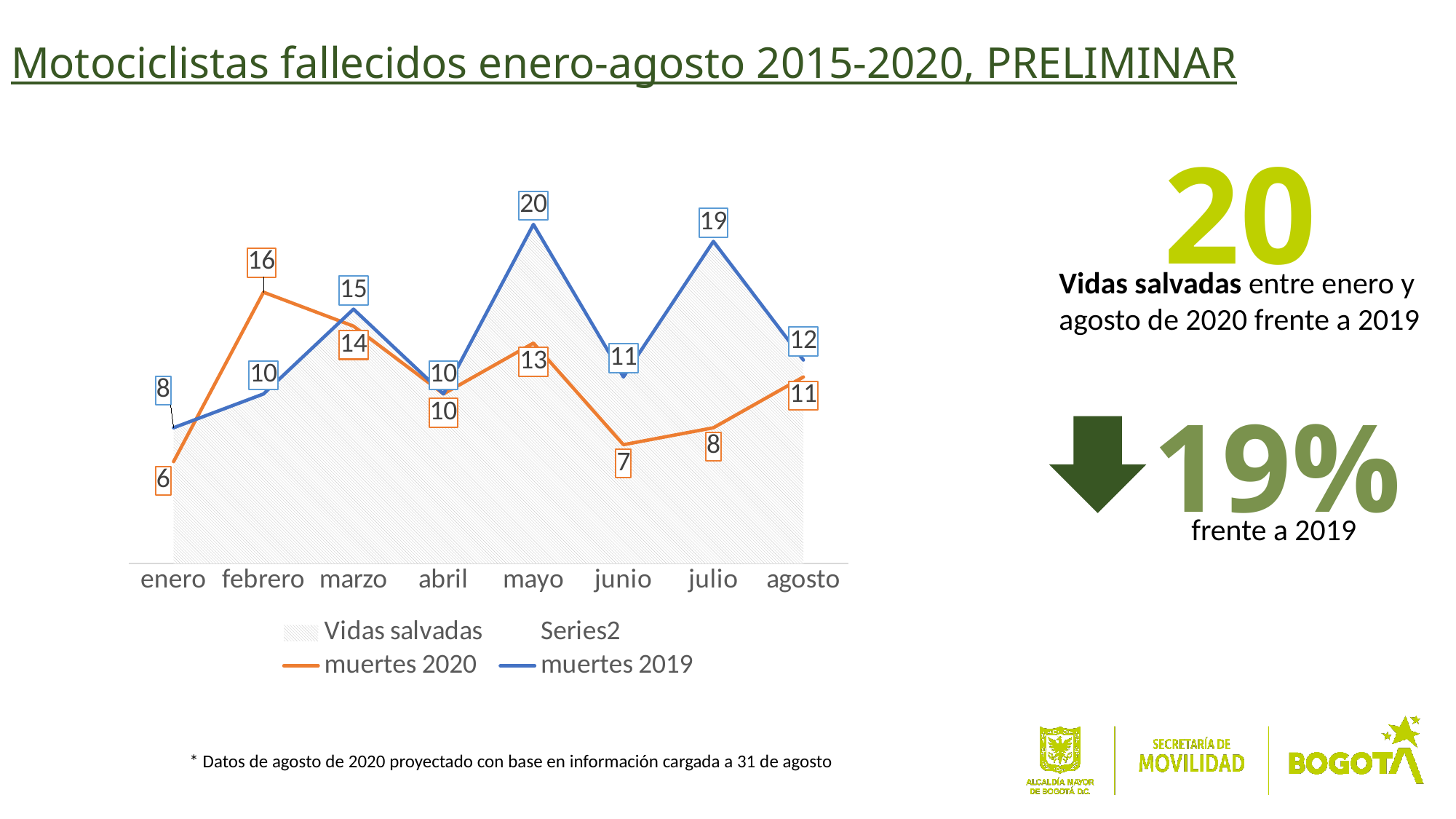
How many entries does the legend list? 4 What is the value for muertes 2020 in junio? 7 Which colour is used for the muertes 2019 line? blue How many months are shown on the x axis? 8 What is the difference between muertes 2019 and muertes 2020 in mayo? 7 What is the value for muertes 2020 in febrero? 16 In which month is muertes 2020 lowest? enero What kind of chart is shown on the slide? combination area and line chart Which is larger in febrero, muertes 2020 or muertes 2019? muertes 2020 What is the value for muertes 2019 in mayo? 20 In which month is muertes 2019 highest? mayo What is the value for muertes 2019 in julio? 19